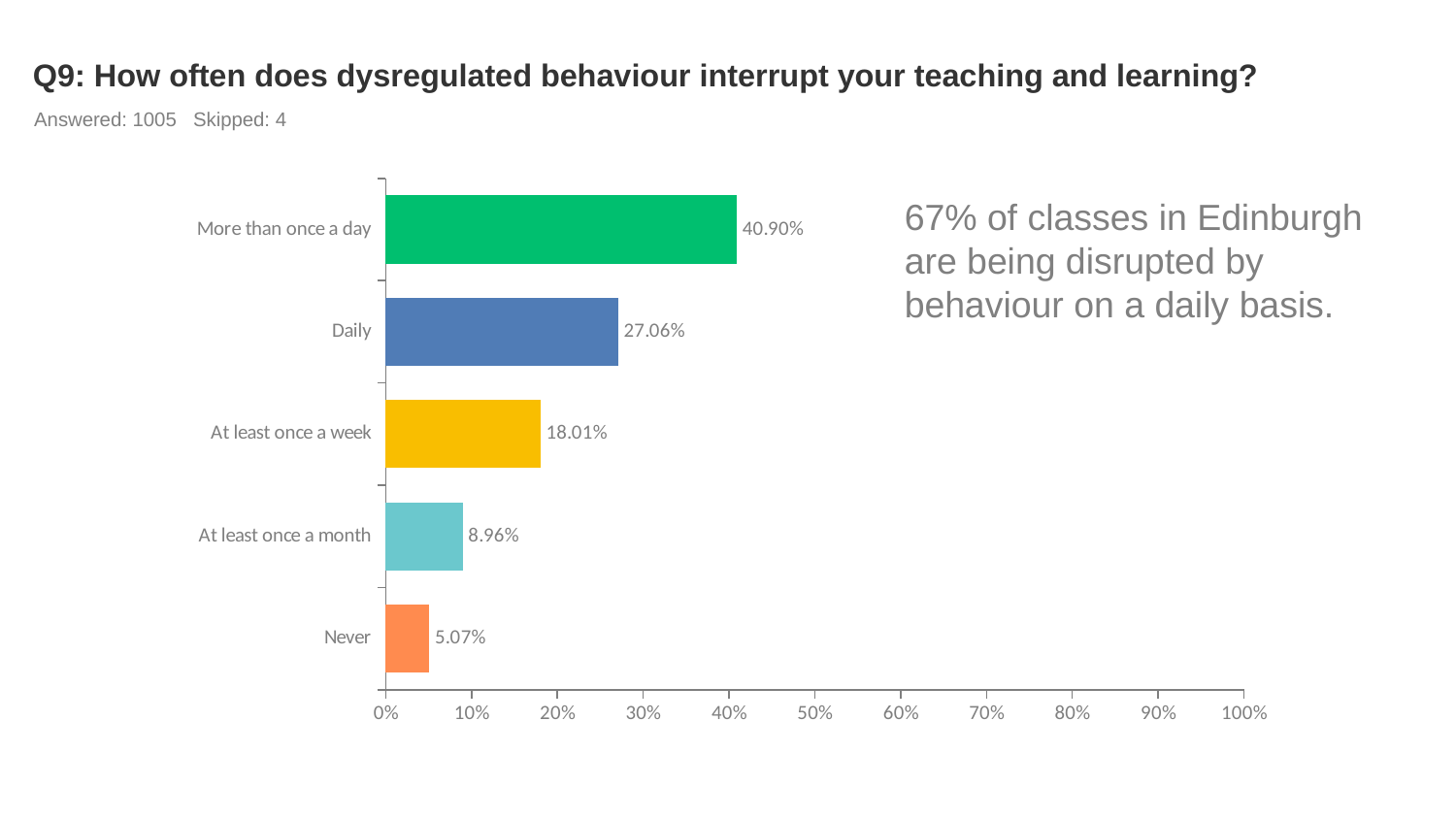
What type of chart is shown on the slide? Bar chart What percentage is shown for 'At least once a week'? 18.01% What is the difference between the 'More than once a day' and 'Daily' percentages? 13.84% How many categories are shown in the chart? 5 How many people answered the question according to the slide? 1005 What percentage of respondents said dysregulated behaviour interrupts their teaching more than once a day? 40.90% Which category has the lowest percentage? Never Which category has the highest percentage? More than once a day What is the value for 'Never'? 5.07% What is the value shown for the 'Daily' category? 27.06% Which is larger: the value for 'At least once a week' or 'At least once a month'? At least once a week Is the value for 'At least once a month' greater or less than 10%? less